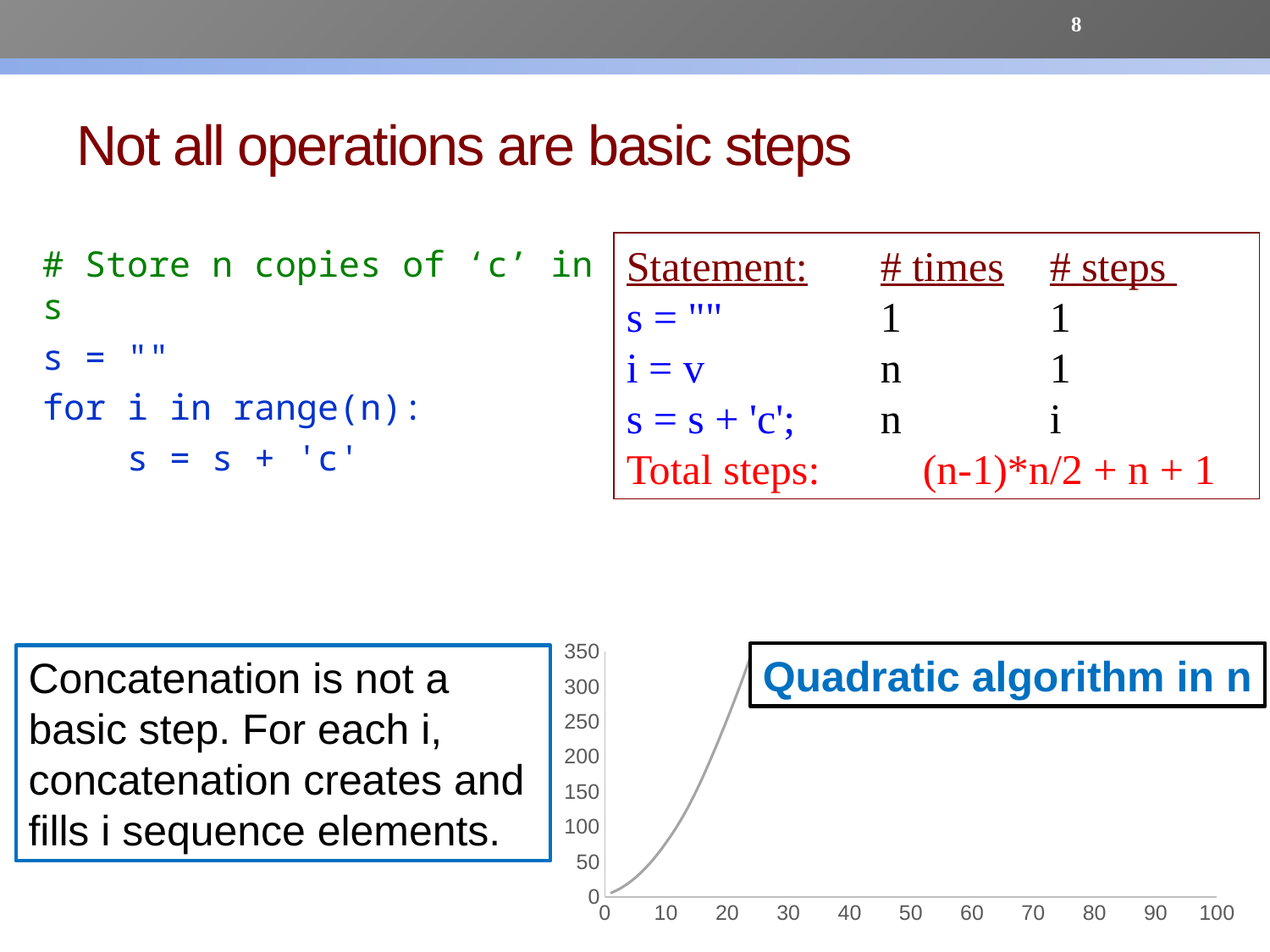
In the chart at the bottom right, do the values rise or fall as the x axis increases? rise In the chart at the bottom right, is the value of the curve at x = 15 greater or less than 300? less In the chart at the bottom right, does the curve rise faster or slower as x increases? faster What is the highest value labelled on the x axis of the chart at the bottom right? 100 What is the highest value labelled on the y axis of the chart at the bottom right? 350 How many tick labels are shown on the x axis of the chart at the bottom right? 11 How many lines are plotted in the chart at the bottom right? 1 What kind of chart is shown at the bottom right of the slide? line chart In the chart at the bottom right, is the value of the curve at x = 5 greater or less than 50? less In the chart at the bottom right, is the value of the curve at x = 20 greater or less than 150? greater